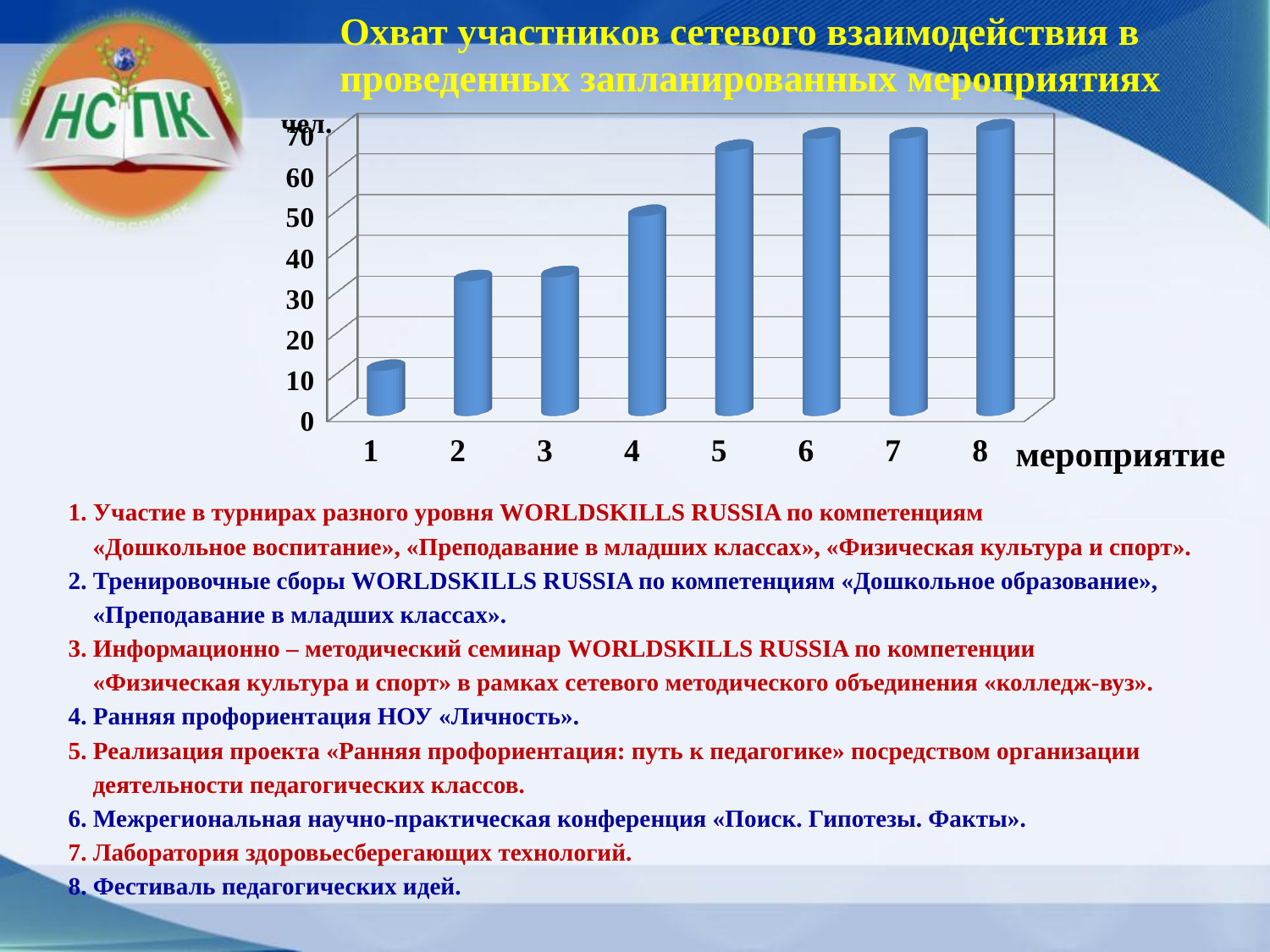
What unit label is shown on the vertical axis of the chart? чел. Which has more participants, event 4 or event 2? event 4 Is the value for event 4 greater or less than 40? greater Which has more participants, event 1 or event 5? event 5 What kind of chart is shown on the slide? bar chart Is the value for event 1 greater or less than 20? less Which event has the lowest number of participants in the chart? 1 Do the values generally rise or fall from event 1 to event 8? rise Is the value for event 8 greater or less than 60? greater How many events (мероприятие) are plotted on the x axis of the chart? 8